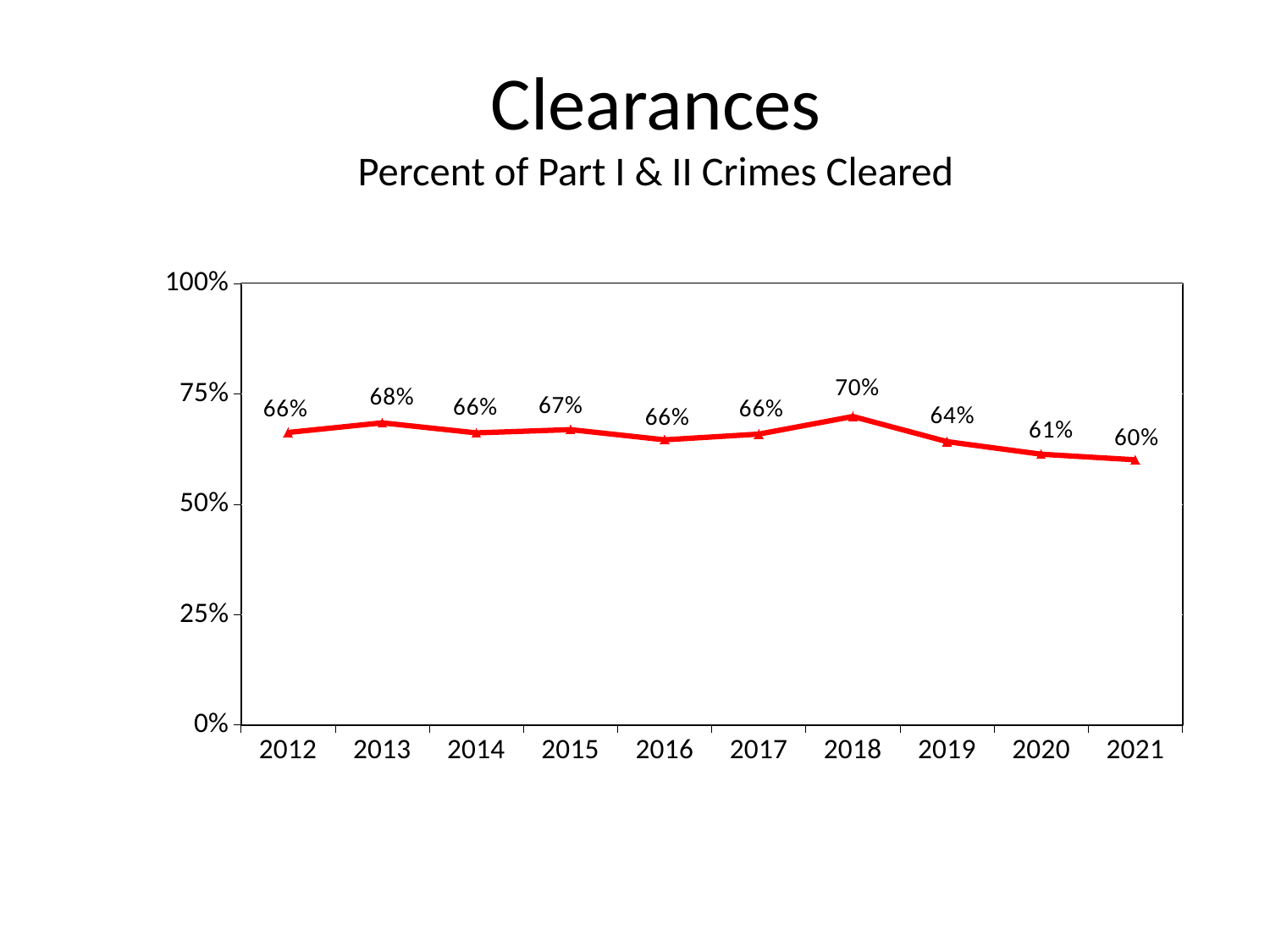
Do the clearance percentages rise or fall from 2018 to 2021? fall What percent of Part I & II crimes were cleared in 2018? 70% Which year had a higher clearance percentage, 2013 or 2020? 2013 Which year has the highest clearance percentage? 2018 What percent of Part I & II crimes were cleared in 2013? 68% Is the value for 2019 greater or less than 50%? greater What is the subtitle of the chart? Percent of Part I & II Crimes Cleared What is the difference in percentage points between the 2018 and 2021 clearance rates? 10 Which year has the lowest clearance percentage? 2021 What kind of chart is shown on the slide? line chart How many years are plotted on the chart? 10 What percent of Part I & II crimes were cleared in 2021? 60%